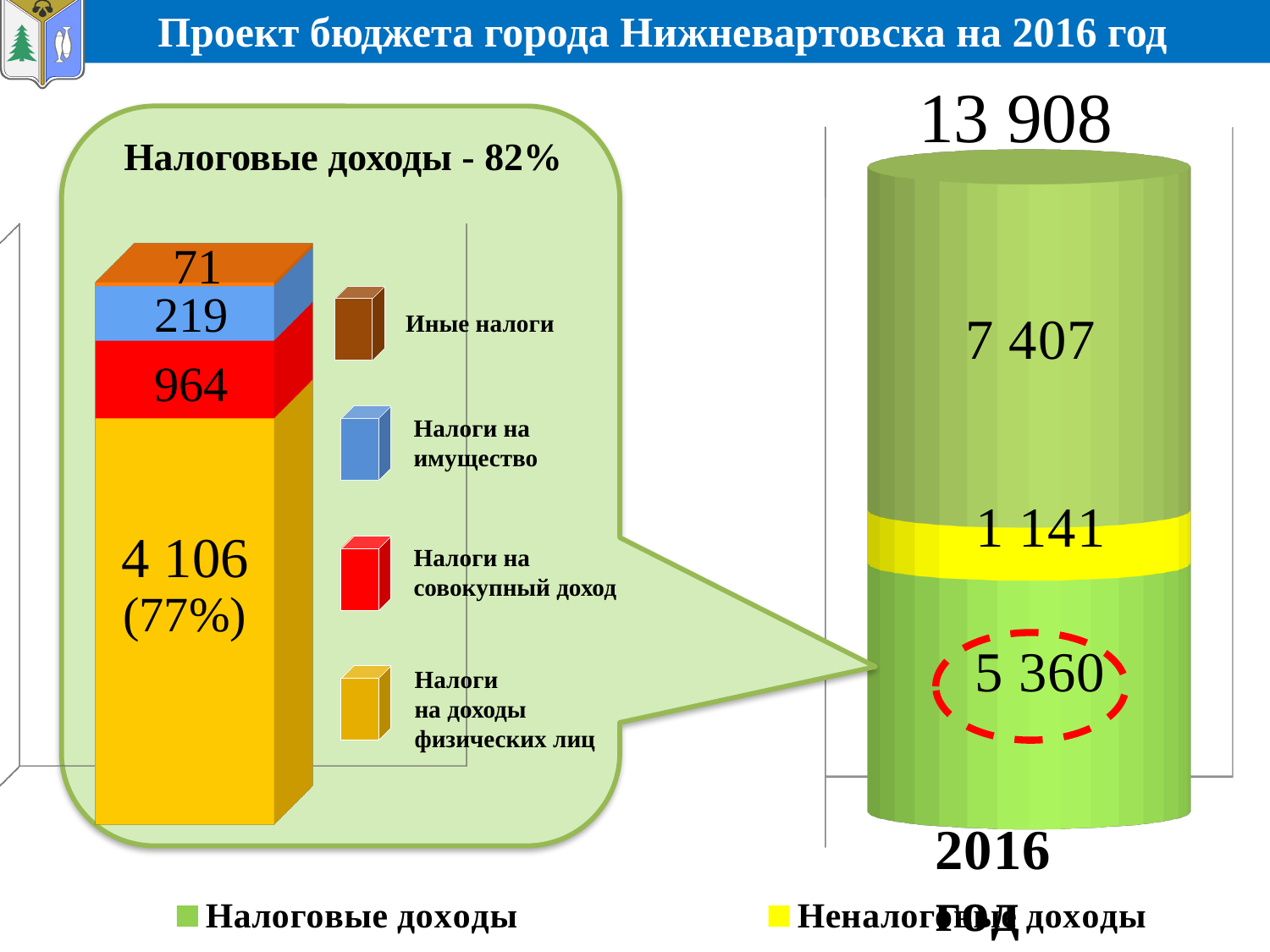
In the left chart titled "Налоговые доходы - 82%", what is the value for "Иные налоги"? 71 In the right chart for 2016 год, which is larger: "Налоговые доходы" or "Неналоговые доходы"? Налоговые доходы In the left chart titled "Налоговые доходы - 82%", what is the difference between "Налоги на совокупный доход" and "Налоги на имущество"? 745 In the left chart titled "Налоговые доходы - 82%", what is the value for "Налоги на совокупный доход"? 964 In the right chart for 2016 год, what is the value for "Неналоговые доходы"? 1 141 In the left chart titled "Налоговые доходы - 82%", what is the value for "Налоги на имущество"? 219 In the left chart titled "Налоговые доходы - 82%", what share of the bar does "Налоги на доходы физических лиц" represent, as printed on the slide? 77% In the right chart for 2016 год, what is the value for "Налоговые доходы"? 5 360 In the right chart for 2016 год, what is the total value printed above the stacked cylinder? 13 908 In the left chart titled "Налоговые доходы - 82%", how many segments make up the stacked bar? 4 In the left chart titled "Налоговые доходы - 82%", what is the value for "Налоги на доходы физических лиц"? 4 106 In the left chart titled "Налоговые доходы - 82%", which segment has the smallest value? Иные налоги